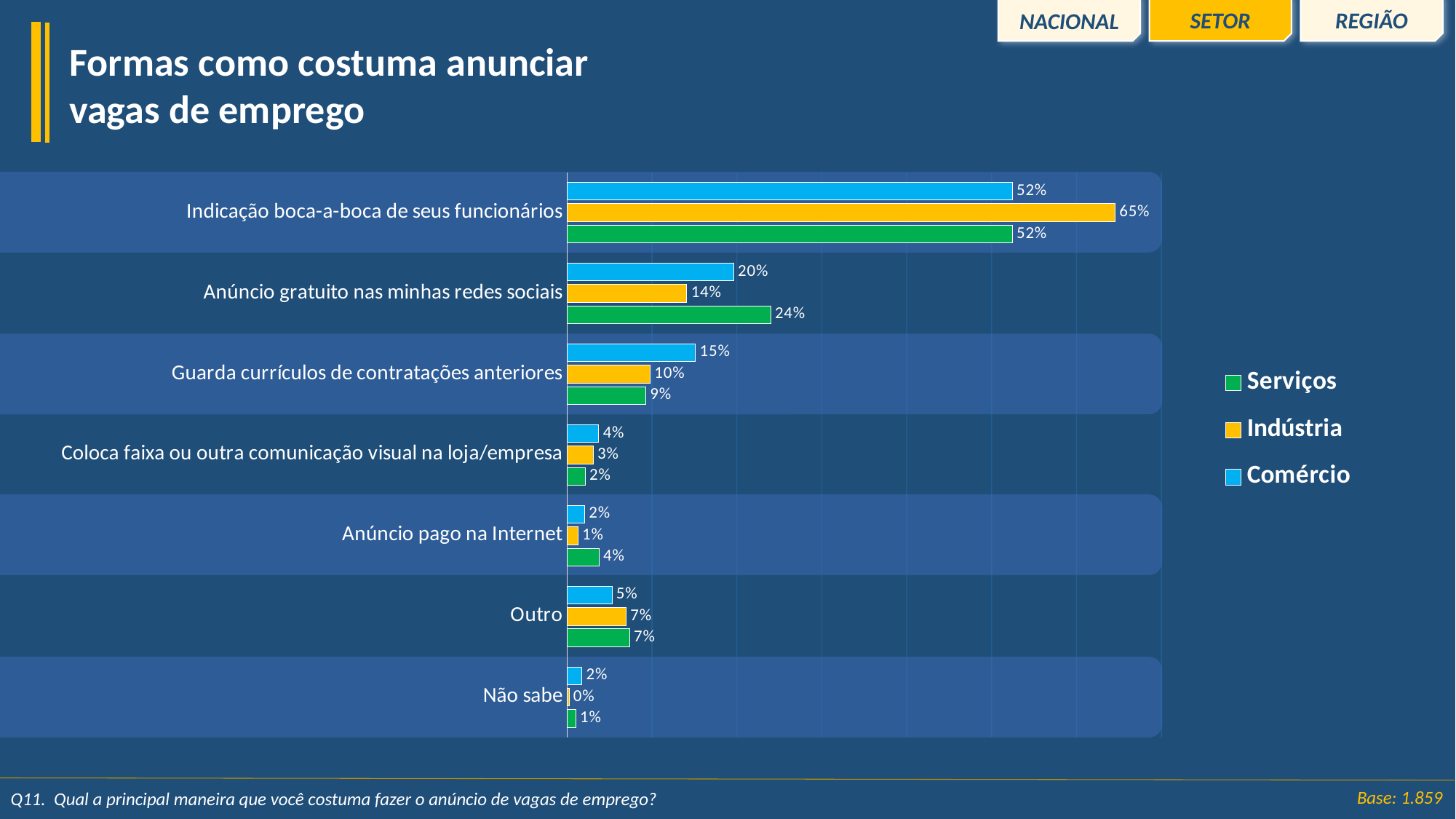
How many categories are shown on the chart? 7 What is the Indústria value for "Não sabe"? 0% How many series does the legend list? 3 Which colour represents the Indústria series in the legend? Yellow What is the Serviços value for "Anúncio gratuito nas minhas redes sociais"? 24% Which category has the highest Comércio value? Indicação boca-a-boca de seus funcionários What is the difference between the Indústria and Comércio values for "Indicação boca-a-boca de seus funcionários"? 13% What is the Indústria value for "Indicação boca-a-boca de seus funcionários"? 65% What kind of chart is shown on the slide? Bar chart What is the Comércio value for "Guarda currículos de contratações anteriores"? 15% Which category has the lowest Serviços value? Não sabe For "Anúncio pago na Internet", which series has the larger value, Serviços or Comércio? Serviços